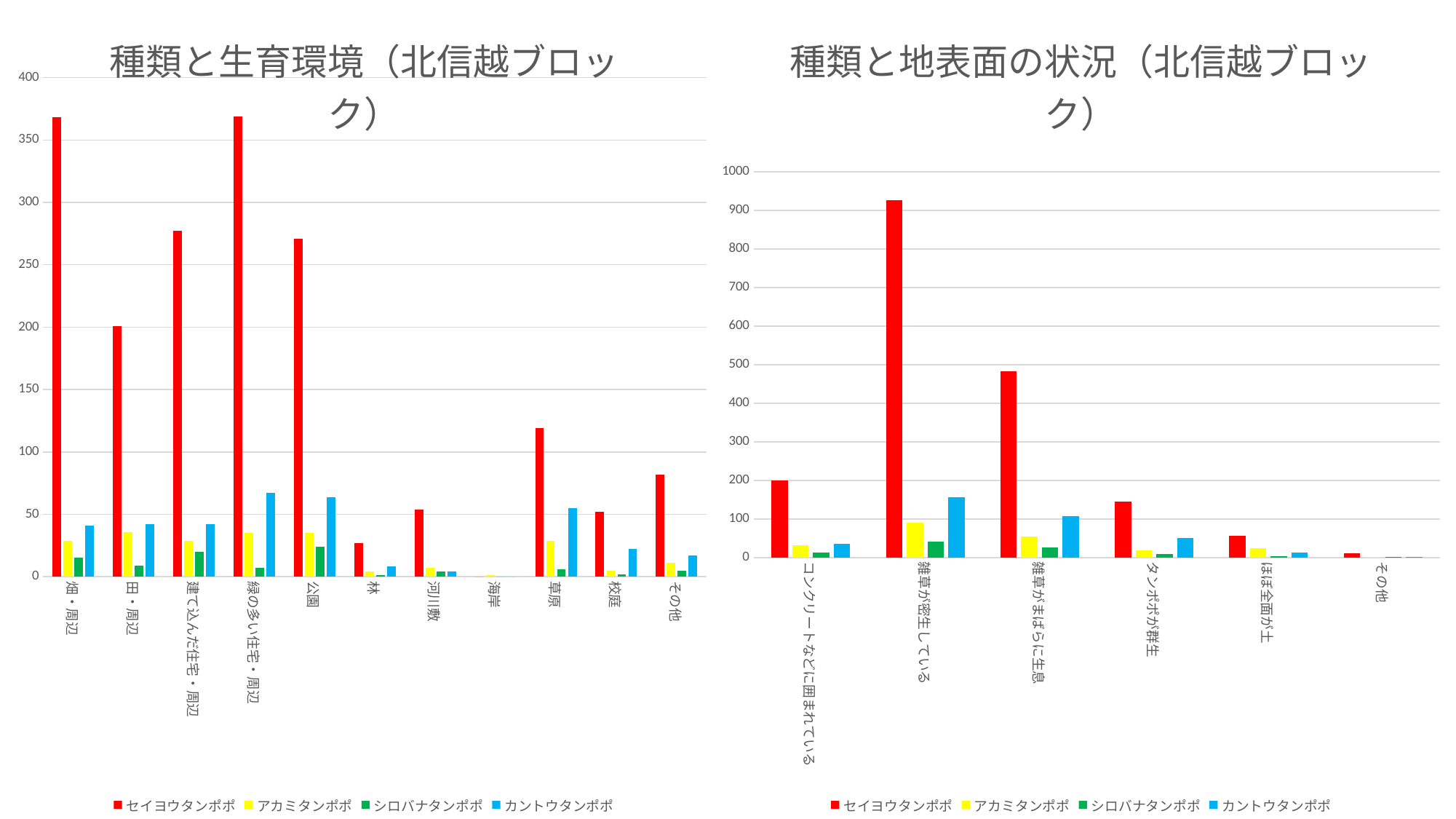
In the right chart 種類と地表面の状況（北信越ブロック）, which colour represents シロバナタンポポ in the legend? green What kind of chart is the left chart titled 種類と生育環境（北信越ブロック）? bar chart In the left chart 種類と生育環境（北信越ブロック）, which is larger for セイヨウタンポポ: 畑・周辺 or 田・周辺? 畑・周辺 How many series does the legend of the right chart 種類と地表面の状況（北信越ブロック） list? 4 In the right chart 種類と地表面の状況（北信越ブロック）, which category has the highest value for セイヨウタンポポ? 雑草が密生している How many categories are shown on the x axis of the right chart 種類と地表面の状況（北信越ブロック）? 6 In the left chart 種類と生育環境（北信越ブロック）, is the value of セイヨウタンポポ for 畑・周辺 greater or less than 350? greater In the right chart 種類と地表面の状況（北信越ブロック）, which category has the lowest value for セイヨウタンポポ? その他 In the right chart 種類と地表面の状況（北信越ブロック）, is the value of セイヨウタンポポ for 雑草がまばらに生息 greater or less than 500? less In the left chart 種類と生育環境（北信越ブロック）, is the value of セイヨウタンポポ for その他 greater or less than 100? less How many categories are shown on the x axis of the left chart 種類と生育環境（北信越ブロック）? 11